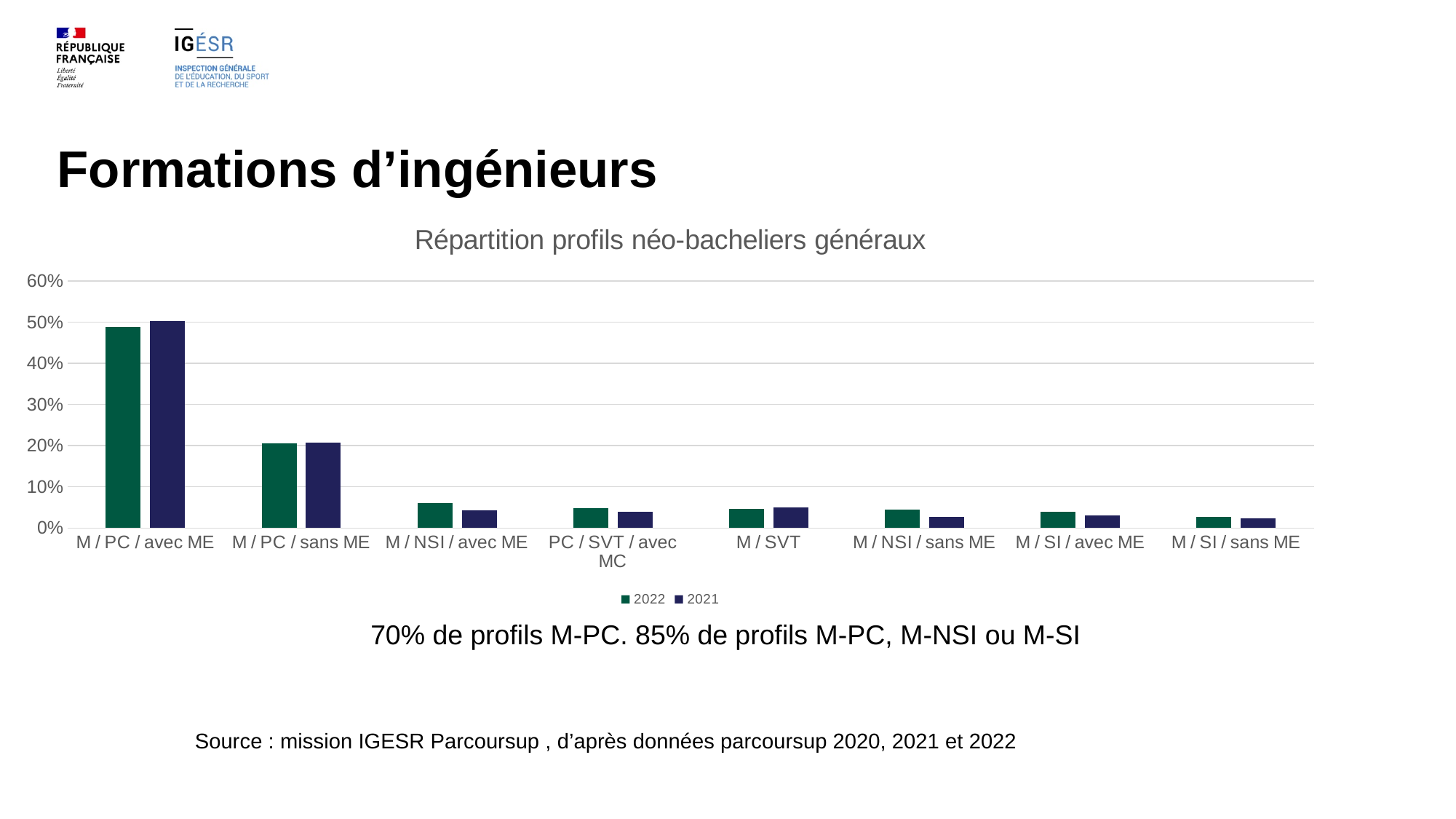
Which years are listed in the chart legend? 2022 and 2021 For M / NSI / sans ME, which series has the larger value, 2022 or 2021? 2022 Which category has the highest value for 2021? M / PC / avec ME How many profile categories are shown on the x axis? 8 What is the title of the chart? Répartition profils néo-bacheliers généraux How many series does the legend list? 2 Which category has the highest value for 2022? M / PC / avec ME Is the 2021 value for M / NSI / avec ME greater or less than 10%? less Is the 2022 value for M / PC / avec ME greater or less than 40%? greater Is the 2022 value for M / PC / sans ME greater or less than 10%? greater What kind of chart is shown on the slide? bar chart Which category has the lowest value for 2022? M / SI / sans ME